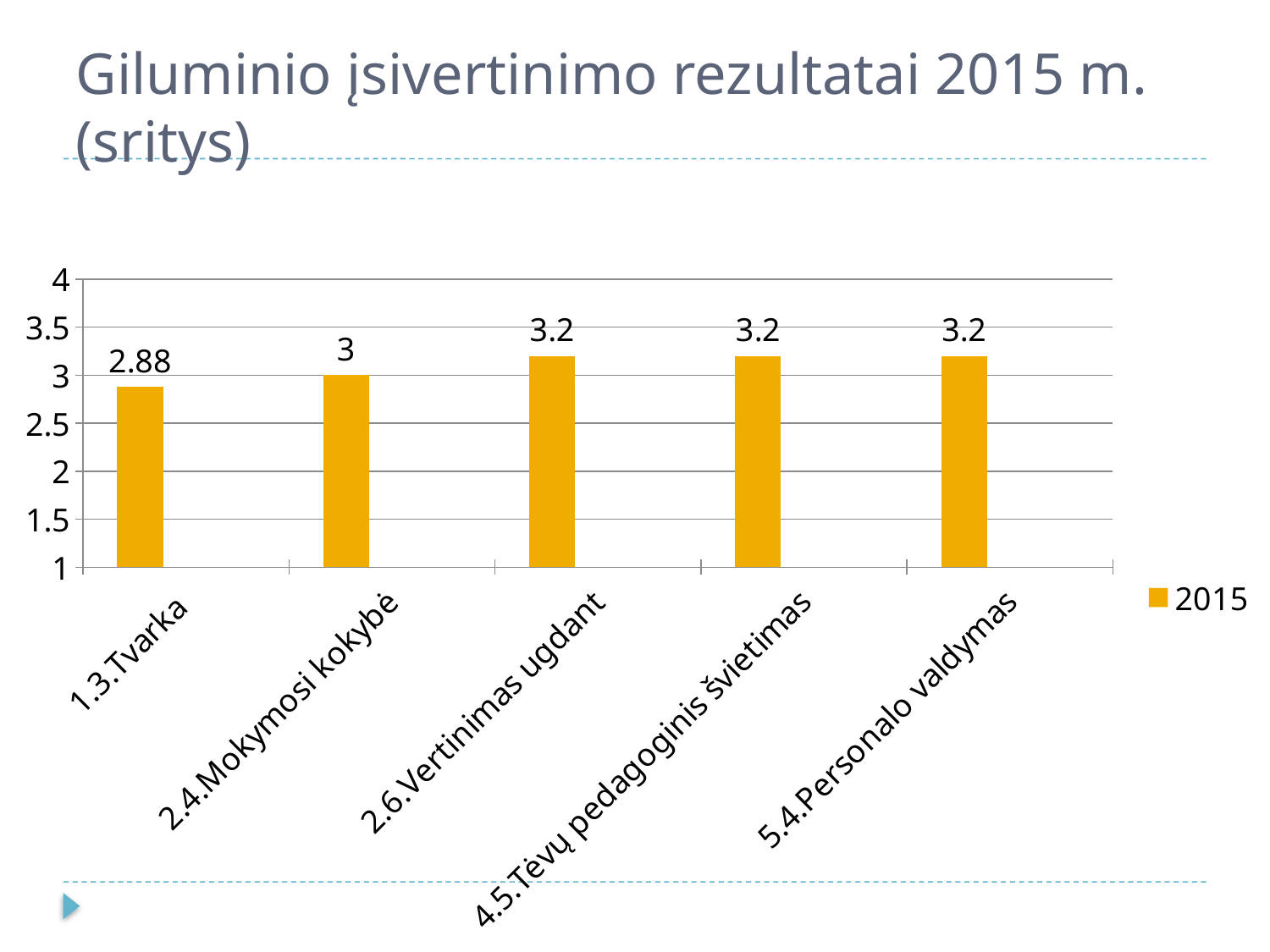
What is the value for 5.4.Personalo valdymas? 3.2 How many categories are shown on the chart? 5 What is the value for 1.3.Tvarka? 2.88 Which category has the lowest value? 1.3.Tvarka What series name is shown in the legend? 2015 Which is larger, the value for 2.4.Mokymosi kokybė or the value for 4.5.Tėvų pedagoginis švietimas? 4.5.Tėvų pedagoginis švietimas What kind of chart is shown on the slide? bar chart What is the value for 2.4.Mokymosi kokybė? 3 Is the value for 1.3.Tvarka greater or less than 3? less What is the difference between the values for 2.6.Vertinimas ugdant and 1.3.Tvarka? 0.32 Do the values rise or fall from 1.3.Tvarka to 2.6.Vertinimas ugdant? rise How many series does the legend list? 1